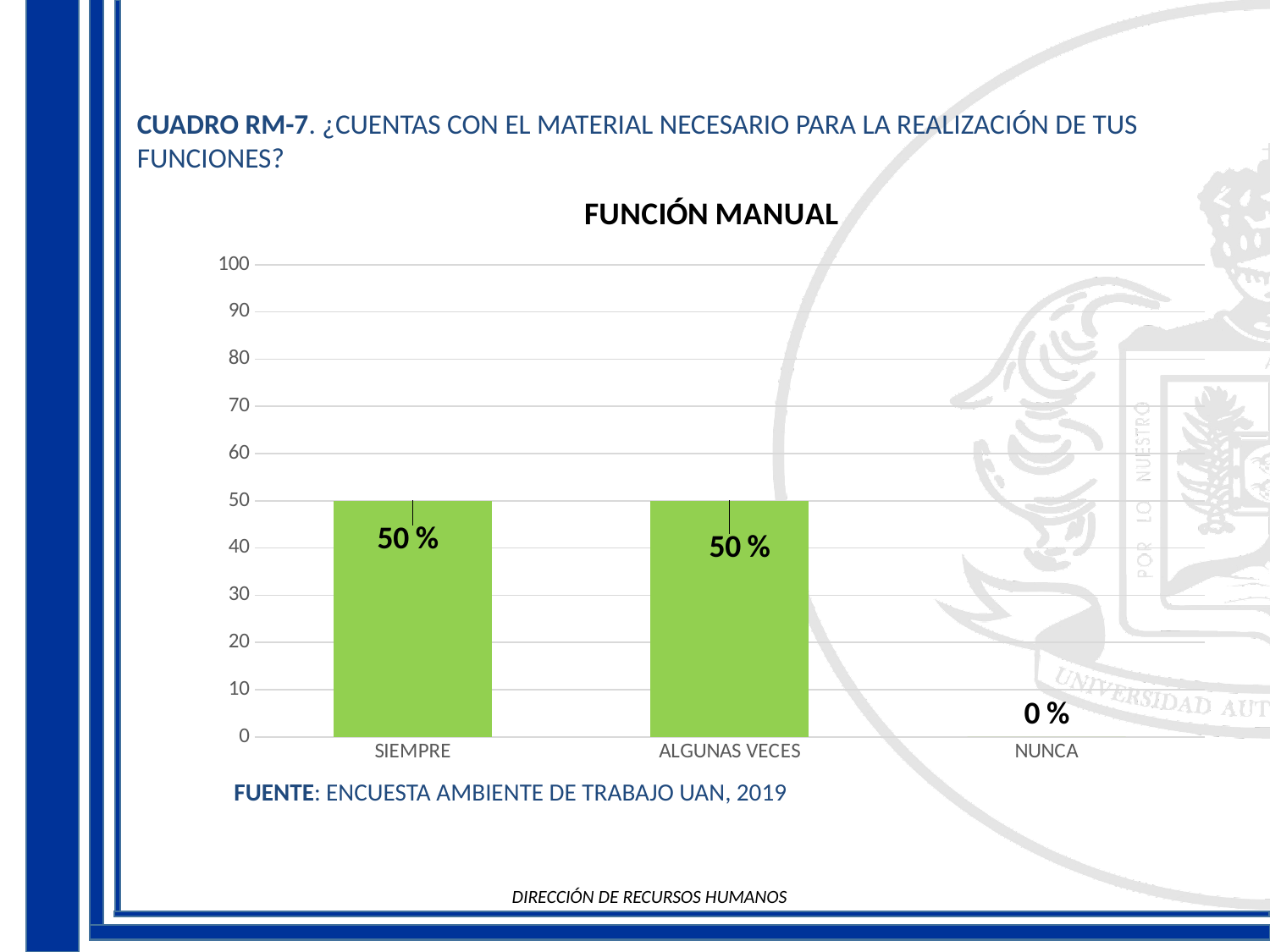
Is the value for SIEMPRE greater or less than 40? greater What is the highest value shown on the y axis? 100 Which is larger, the value for ALGUNAS VECES or the value for NUNCA? ALGUNAS VECES What is the value for SIEMPRE? 50 % What is the value for NUNCA? 0 % What is the title of the chart? FUNCIÓN MANUAL How many categories are shown on the x axis? 3 What kind of chart is shown on the slide? bar chart What colour are the bars in the chart? green Which category has the lowest value? NUNCA What is the value for ALGUNAS VECES? 50 % What is the difference between the values for SIEMPRE and NUNCA? 50 %